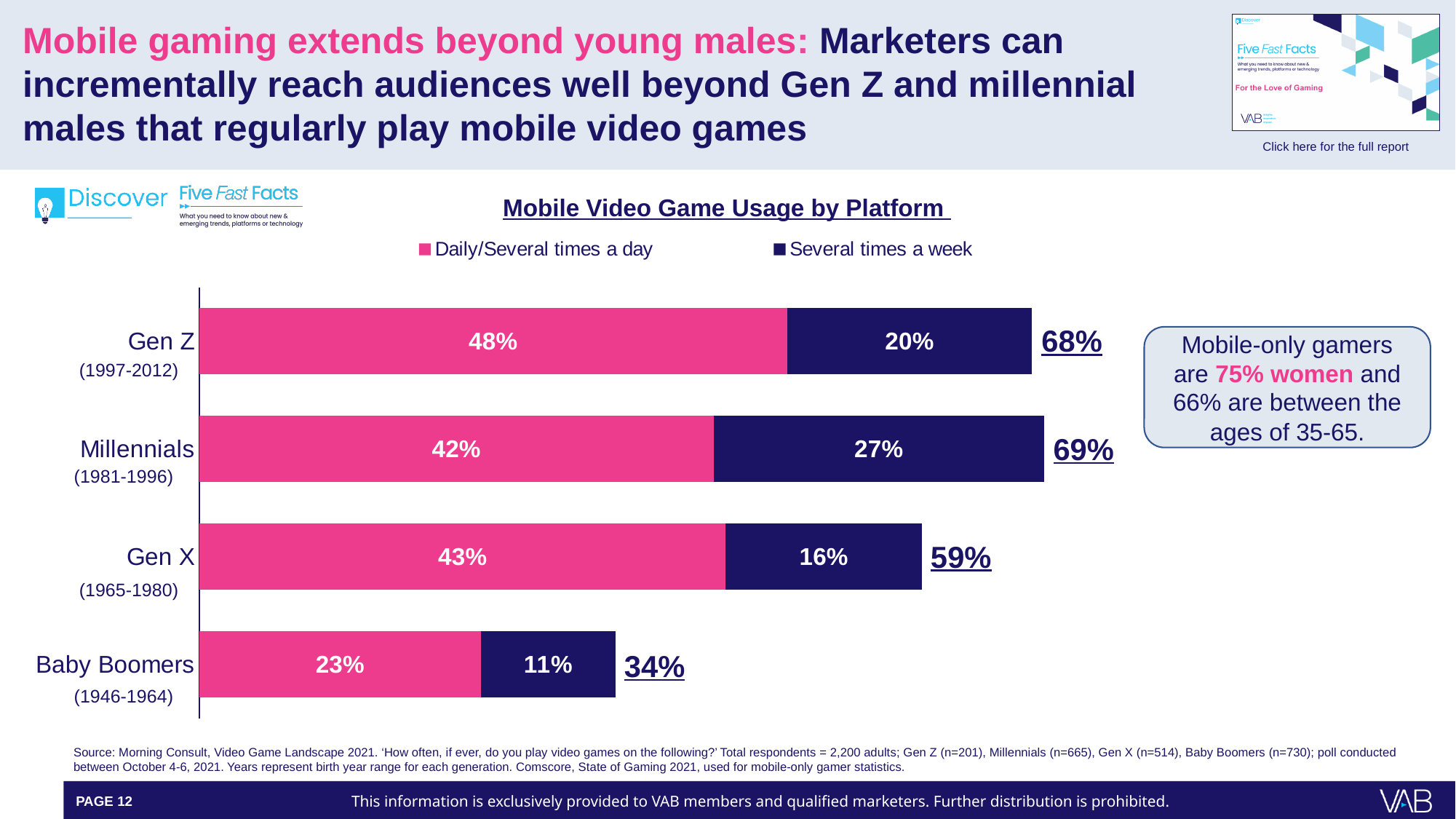
What is the difference between the Daily/Several times a day values for Gen Z and Baby Boomers? 25% How many series does the legend list? 2 How many generations are shown in the chart? 4 What is the total of the stacked bar for Gen X? 59% What kind of chart is shown on the slide? Stacked bar chart What is the Several times a week value for Millennials? 27% Which generation has the lowest Several times a week value? Baby Boomers Which is larger: the Several times a week value for Millennials or for Gen Z? Millennials What is the Daily/Several times a day value for Gen Z? 48% What is the Daily/Several times a day value for Baby Boomers? 23% What is the Several times a week value for Gen X? 16% Which generation has the highest Daily/Several times a day value? Gen Z